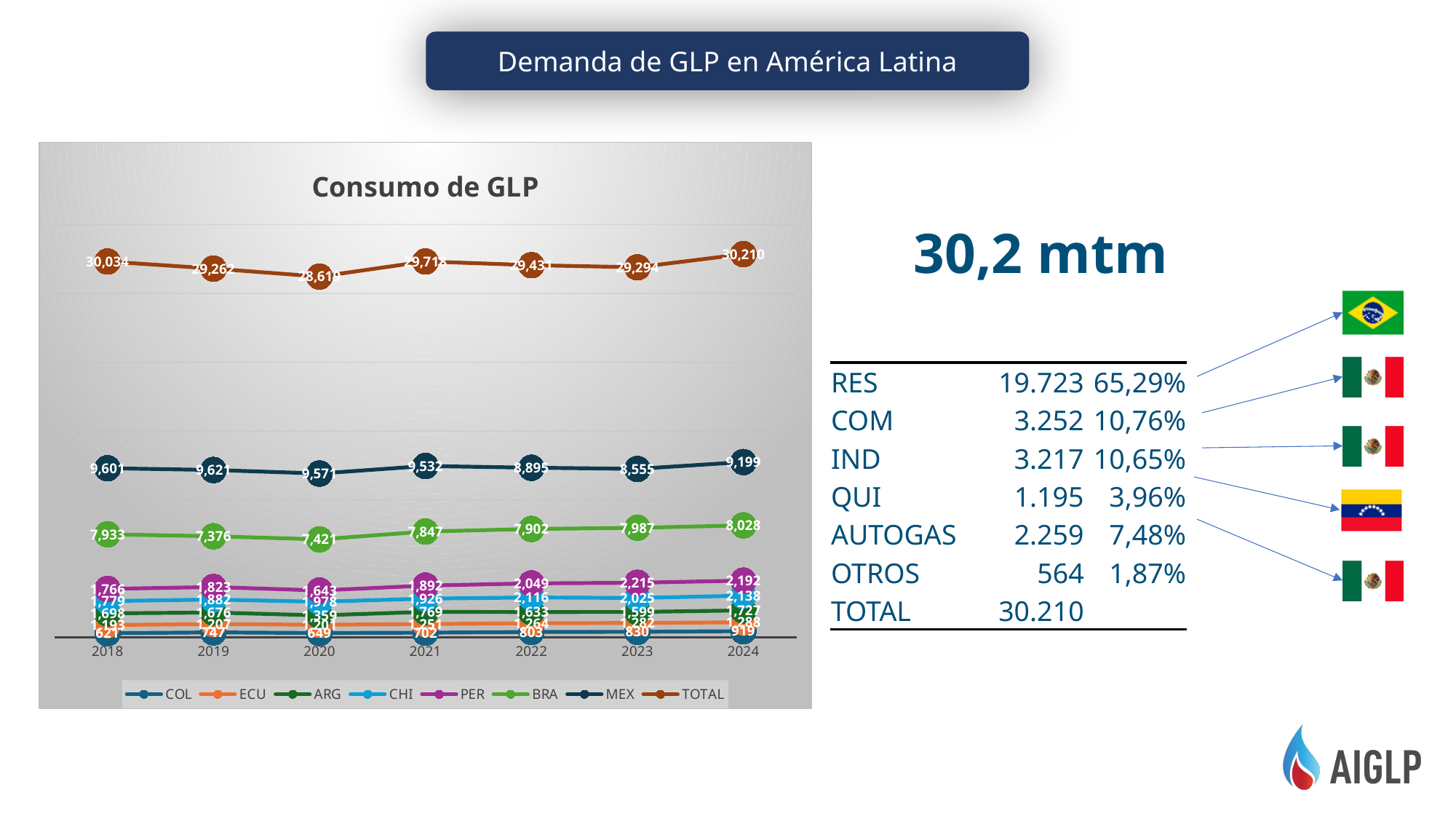
How many years are shown on the x axis of the "Consumo de GLP" chart? 7 In the "Consumo de GLP" chart, in which year is the TOTAL series highest? 2024 In the "Consumo de GLP" chart, what is the difference between the TOTAL values for 2024 and 2018? 176 What kind of chart is "Consumo de GLP"? line chart In the "Consumo de GLP" chart, what is the PER value for 2023? 2,215 In the "Consumo de GLP" chart, what is the BRA value for 2024? 8,028 In the "Consumo de GLP" chart, what is the MEX value for 2022? 8,895 In the "Consumo de GLP" chart, does the BRA series rise or fall from 2020 to 2024? rise How many series does the legend of the "Consumo de GLP" chart list? 8 In the "Consumo de GLP" chart, which series has the larger value in 2024, MEX or BRA? MEX In the "Consumo de GLP" chart, what is the TOTAL value for 2024? 30,210 In the "Consumo de GLP" chart, in which year is the TOTAL series lowest? 2020